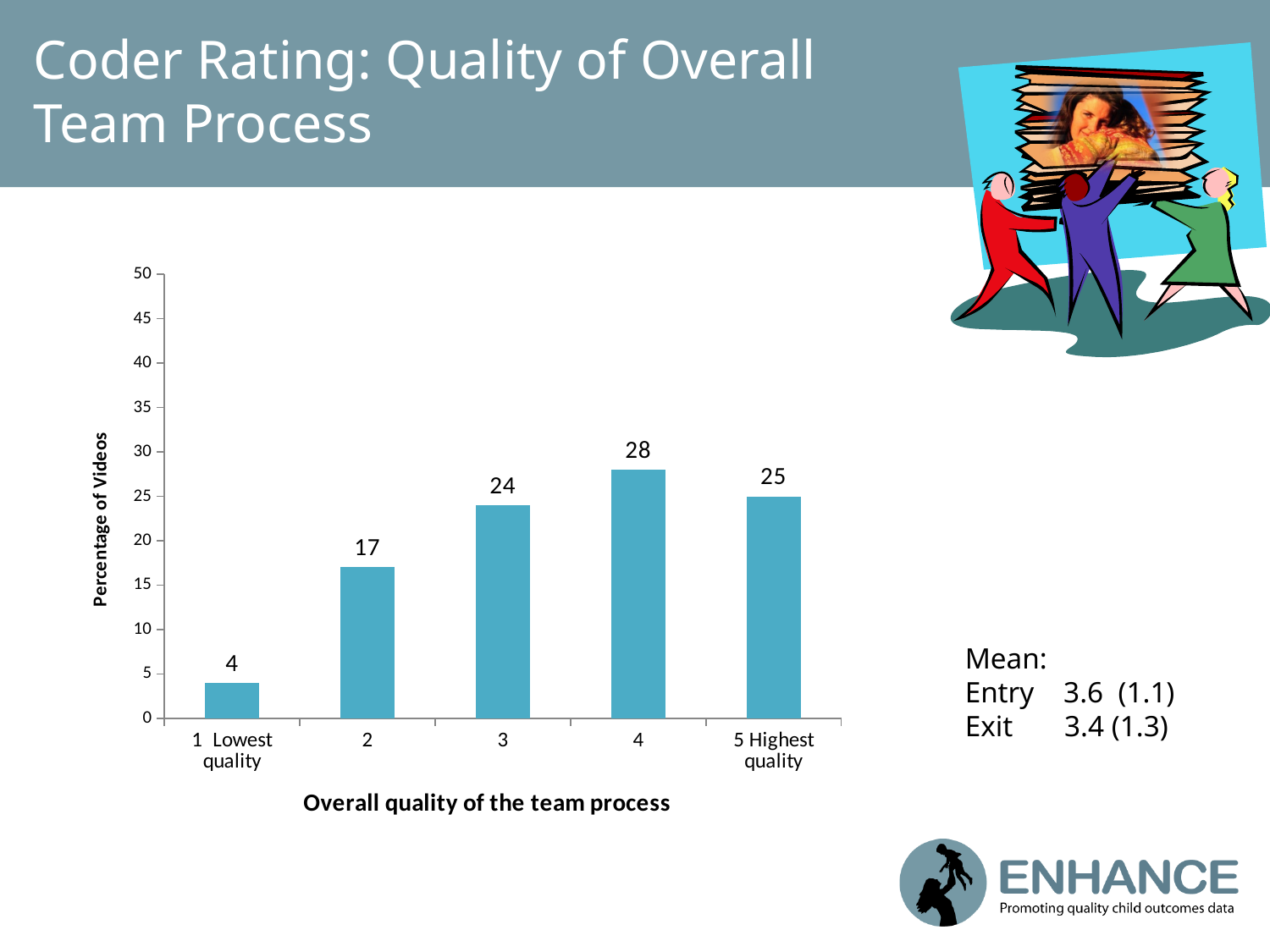
What is the difference in percentage of videos between rating 4 and rating 2? 11 How many rating categories are shown on the x axis? 5 What percentage of videos received a rating of 4 for overall quality of the team process? 28 What percentage of videos received a rating of 3? 24 Which rating category has the lowest percentage of videos? 1 Lowest quality Which has a higher percentage of videos: rating 3 or rating '5 Highest quality'? 5 Highest quality Which rating category has the highest percentage of videos? 4 What is the label of the y axis of the chart? Percentage of Videos Is the percentage of videos for rating 2 greater or less than 20? less What is the label of the x axis of the chart? Overall quality of the team process What percentage of videos received the rating '1 Lowest quality'? 4 What kind of chart is shown on the slide? bar chart